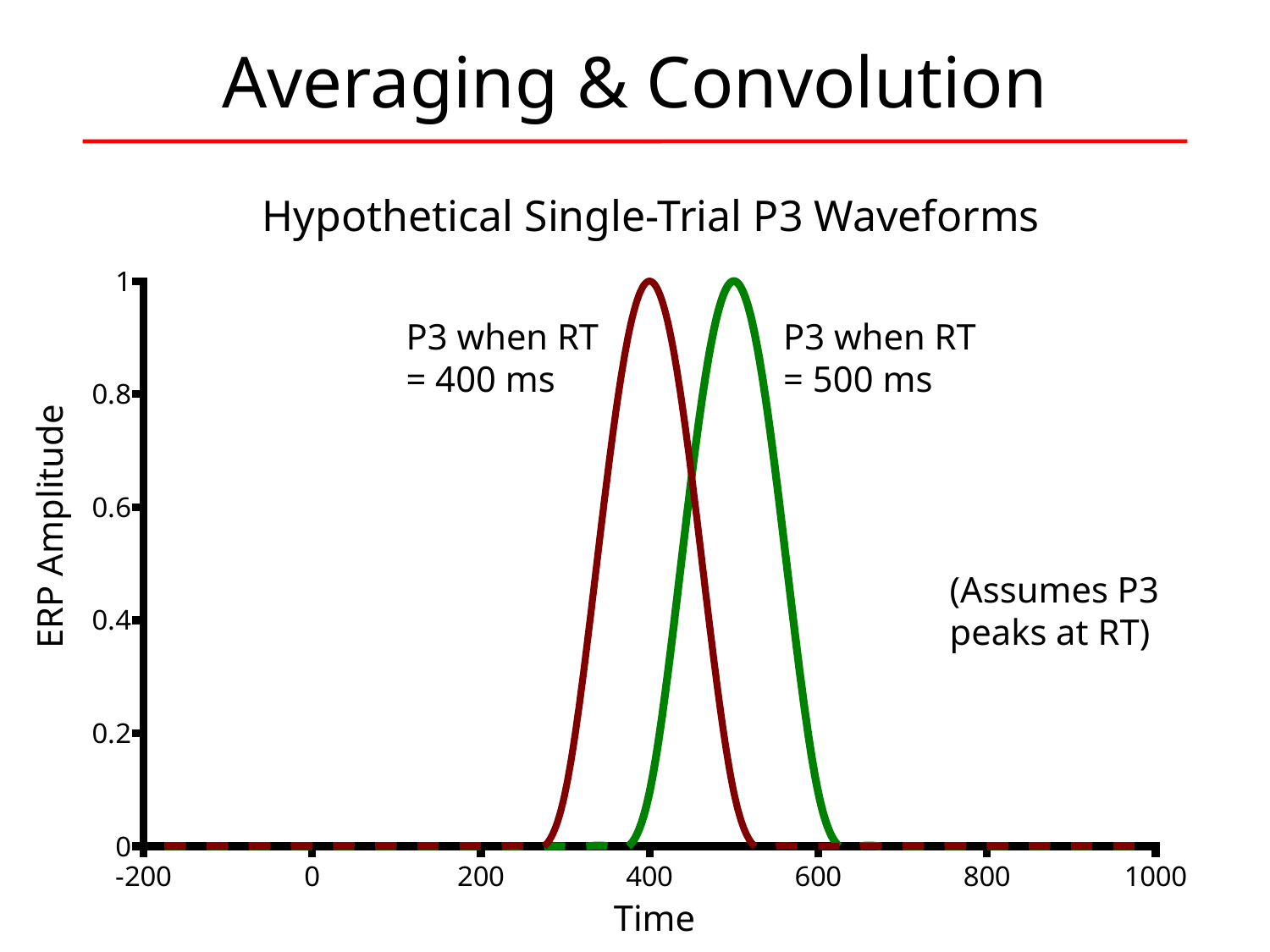
At what time does the 'P3 when RT = 400 ms' waveform reach its peak? 400 At time 600, which waveform has the higher ERP Amplitude, 'P3 when RT = 400 ms' or 'P3 when RT = 500 ms'? P3 when RT = 500 ms What kind of chart is shown on the slide? Line chart What is the peak ERP Amplitude of the 'P3 when RT = 400 ms' waveform? 1 What is the ERP Amplitude of the 'P3 when RT = 500 ms' waveform at time 200? 0 What is the label of the y axis? ERP Amplitude How many waveforms are plotted on the chart? 2 Is the ERP Amplitude of the 'P3 when RT = 500 ms' waveform at time 400 greater or less than 0.2? less What is the ERP Amplitude of the 'P3 when RT = 400 ms' waveform at time 600? 0 Is the ERP Amplitude of the 'P3 when RT = 400 ms' waveform at time 400 greater or less than 0.8? greater At what time does the 'P3 when RT = 500 ms' waveform reach its peak? 500 What is the title of the chart? Hypothetical Single-Trial P3 Waveforms